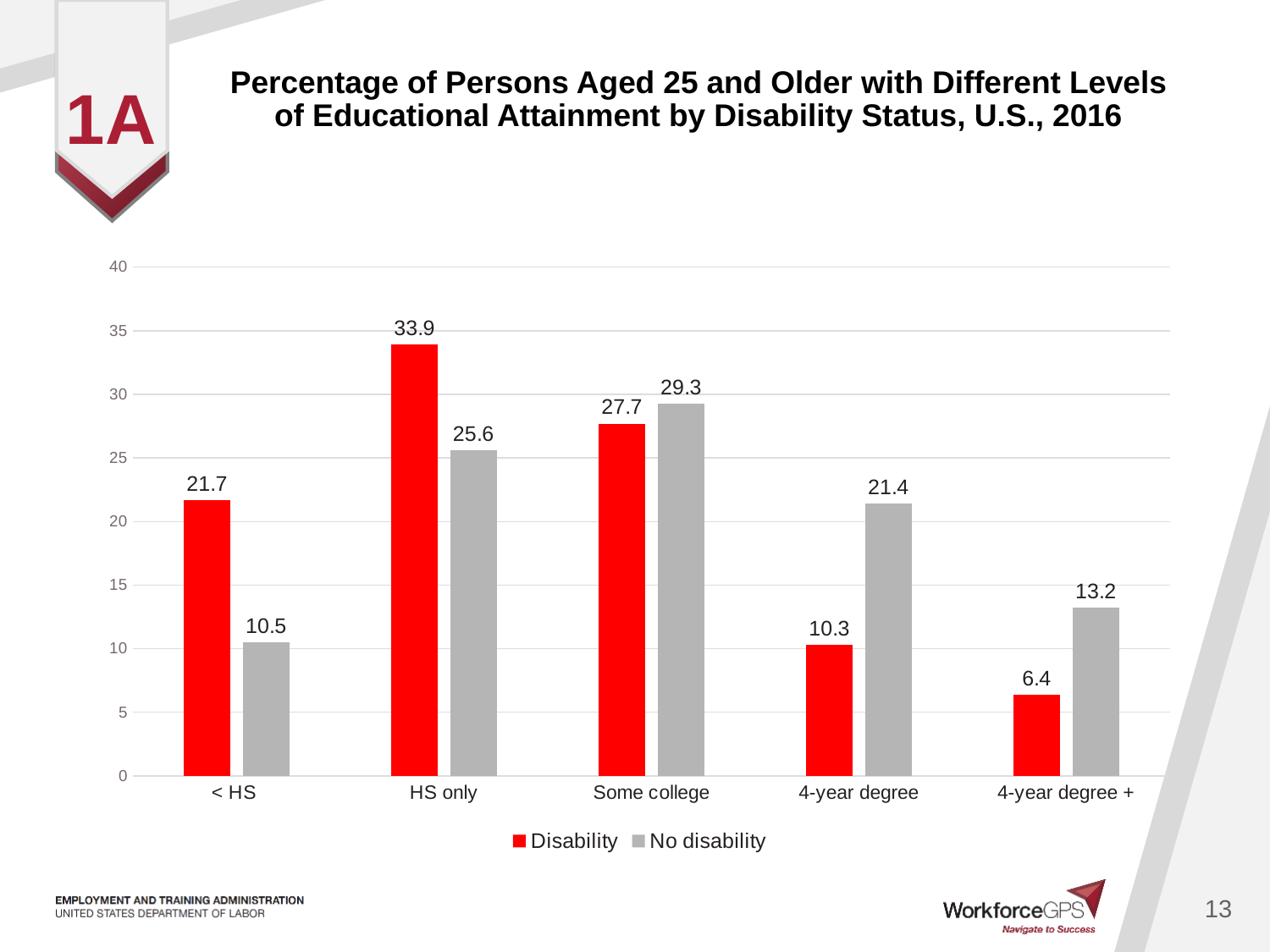
What is the No disability value for 4-year degree +? 13.2 Which category has the lowest No disability value? < HS How many education categories are shown on the x axis? 5 What is the Disability value for HS only? 33.9 What colour are the Disability bars? Red What kind of chart is shown on the slide? Bar chart For Some college, which series has the larger value, Disability or No disability? No disability What is the No disability value for < HS? 10.5 Which category has the highest Disability value? HS only What is the difference between the No disability and Disability values for 4-year degree? 11.1 What is the difference between the Disability and No disability values for < HS? 11.2 How many series does the legend list? 2